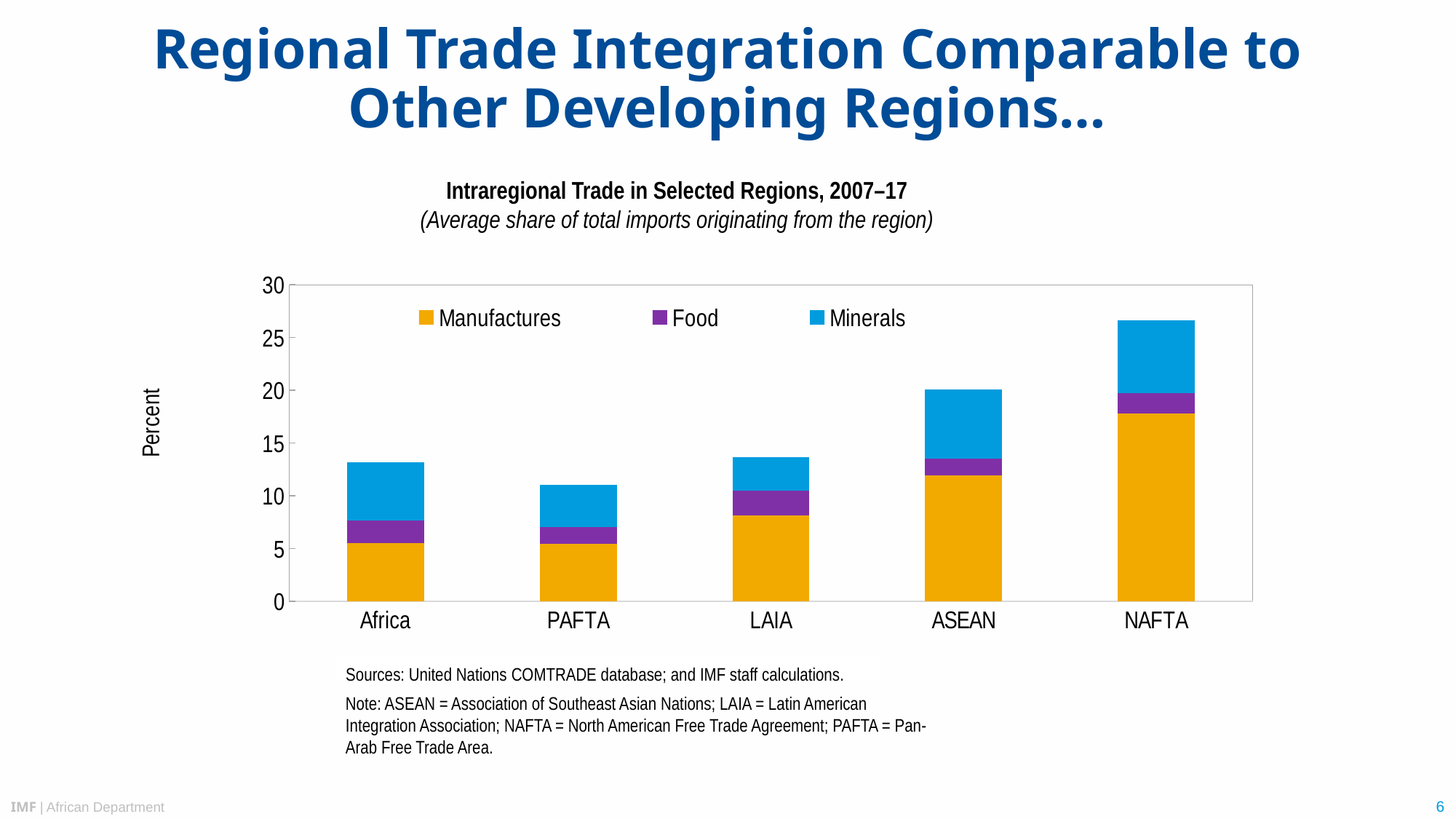
What kind of chart is shown on the slide? Stacked bar chart Which has the larger total bar, ASEAN or LAIA? ASEAN Which region has the highest total intraregional trade share in the chart? NAFTA What is the label on the y axis of the chart? Percent Is the total bar for NAFTA greater or less than 25? greater Is the total bar for Africa greater or less than 15? less Which region has the lowest total intraregional trade share in the chart? PAFTA Is the Manufactures value for NAFTA greater or less than 15? greater What is the title of the chart? Intraregional Trade in Selected Regions, 2007–17 How many regions are shown on the x axis of the chart? 5 How many series does the chart's legend list? 3